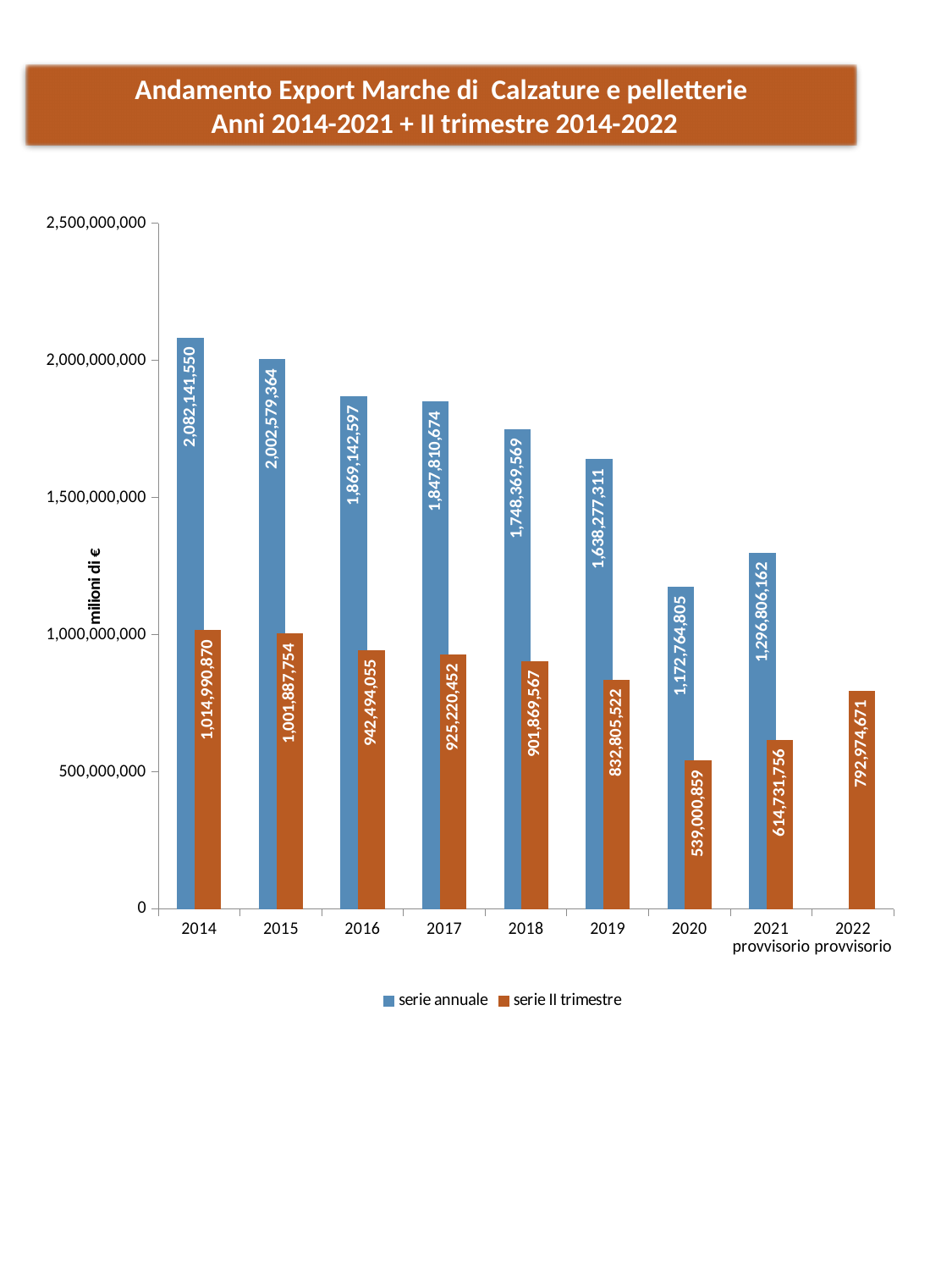
What is the difference between the serie annuale values for 2014 and 2015? 79,562,186 What kind of chart is shown on the slide? Bar chart Which year has the lowest value for serie II trimestre? 2020 How many year categories are shown on the x axis? 9 Which is larger: serie II trimestre for 2019 or serie II trimestre for 2022 provvisorio? 2019 What is the value of serie II trimestre for 2022 provvisorio? 792,974,671 How many series does the legend list? 2 What is the value of serie II trimestre for 2018? 901,869,567 What is the value of serie annuale for 2014? 2,082,141,550 Which year has the highest value for serie annuale? 2014 What is the value of serie annuale for 2021 provvisorio? 1,296,806,162 Do the serie II trimestre values rise or fall from 2014 to 2020? Fall